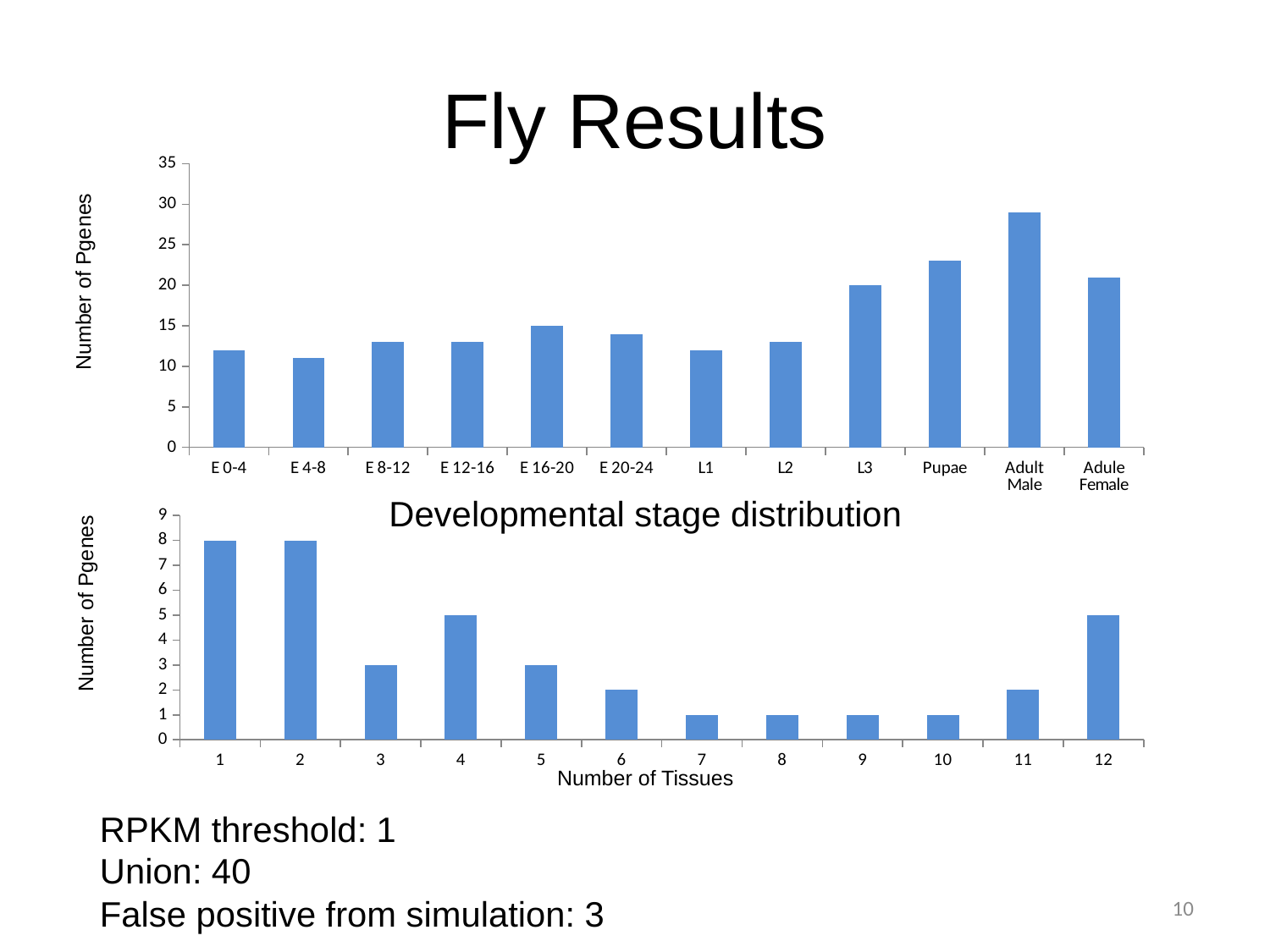
In the bottom chart (Number of Tissues), which has more Pgenes: 4 tissues or 6 tissues? 4 tissues In the top chart (Developmental stage distribution), is the value for E 4-8 greater or less than 15? less In the bottom chart (Number of Tissues), what is the difference between the number of Pgenes for 2 tissues and for 3 tissues? 5 What kind of chart is the top chart (Developmental stage distribution)? Bar chart In the bottom chart (Number of Tissues), how many categories are shown on the x axis? 12 In the top chart (Developmental stage distribution), which developmental stage has the highest number of Pgenes? Adult Male In the bottom chart (Number of Tissues), what is the number of Pgenes for 1 tissue? 8 In the top chart (Developmental stage distribution), is the value for Adult Male greater or less than 25? greater In the bottom chart (Number of Tissues), what is the number of Pgenes for 4 tissues? 5 In the bottom chart (Number of Tissues), what is the number of Pgenes for 12 tissues? 5 In the bottom chart (Number of Tissues), what is the number of Pgenes for 7 tissues? 1 In the top chart (Developmental stage distribution), which has more Pgenes: Pupae or L1? Pupae